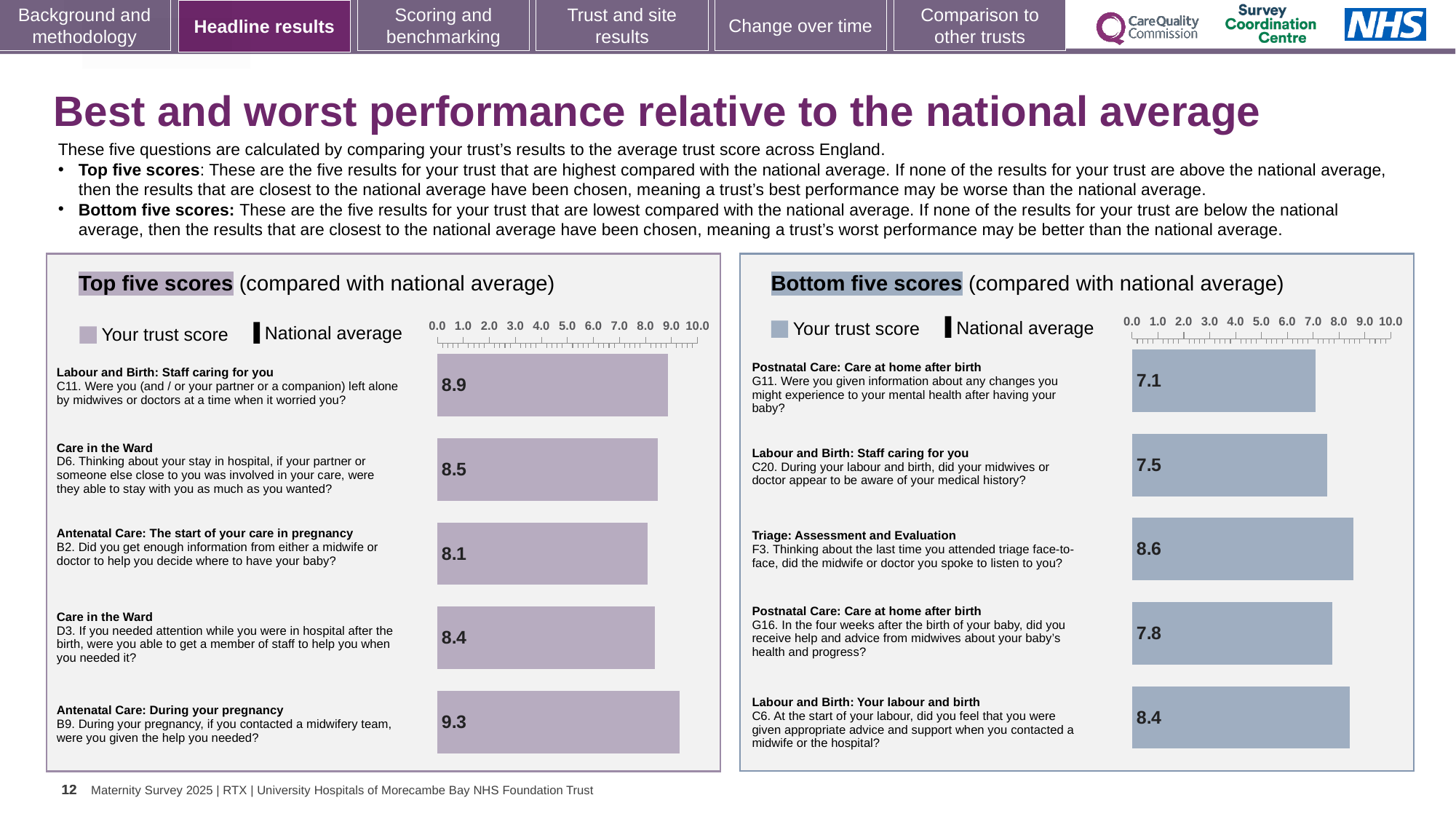
In the Top five scores chart, what is the trust score for question D3 (able to get a member of staff to help you when you needed it)? 8.4 In the Top five scores chart, what is the trust score for question C11 (left alone by midwives or doctors at a time when it worried you)? 8.9 How many bars are shown in the Top five scores chart? 5 In the Top five scores chart, what is the difference between the trust scores for B9 and B2? 1.2 How many entries does the legend of the Bottom five scores chart list? 2 In the Top five scores chart, which question has the highest trust score? B9 (Antenatal Care: During your pregnancy) What is the maximum value shown on the axis of the Bottom five scores chart? 10.0 In the Bottom five scores chart, which question has the lowest trust score? G11 (Postnatal Care: Care at home after birth) In the Bottom five scores chart, which has the larger trust score: F3 or C6? F3 In the Bottom five scores chart, what is the trust score for question G11 (information about changes to your mental health after having your baby)? 7.1 In the Bottom five scores chart, what is the difference between the trust scores for F3 and G11? 1.5 What type of chart is used for the Top five scores? Bar chart